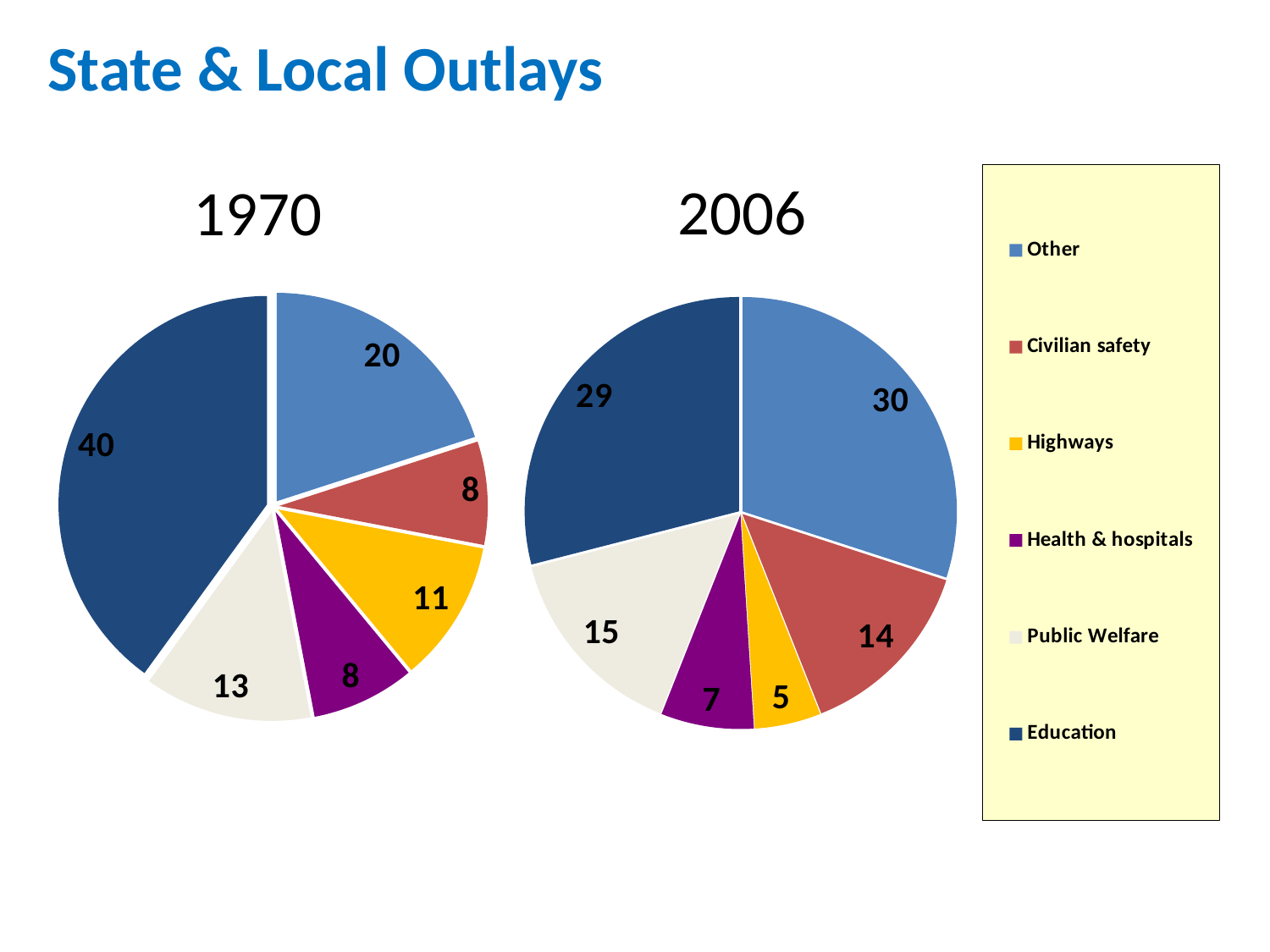
In the 1970 pie chart, which category has the largest slice? Education In the 1970 pie chart, what is the value for Education? 40 In the 2006 pie chart, what is the value for Public Welfare? 15 In the 2006 pie chart, which category has the largest slice? Other In the 2006 pie chart, which is larger: Civilian safety or Health & hospitals? Civilian safety In the 2006 pie chart, what is the value for Other? 30 In the 1970 pie chart, what is the value for Highways? 11 What colour represents Highways in the legend? Yellow In the 2006 pie chart, which category has the smallest slice? Highways What is the difference between the Education value in the 1970 pie chart and the Education value in the 2006 pie chart? 11 How many slices does the 1970 pie chart have? 6 What type of chart is used for the 1970 and 2006 data? Pie chart